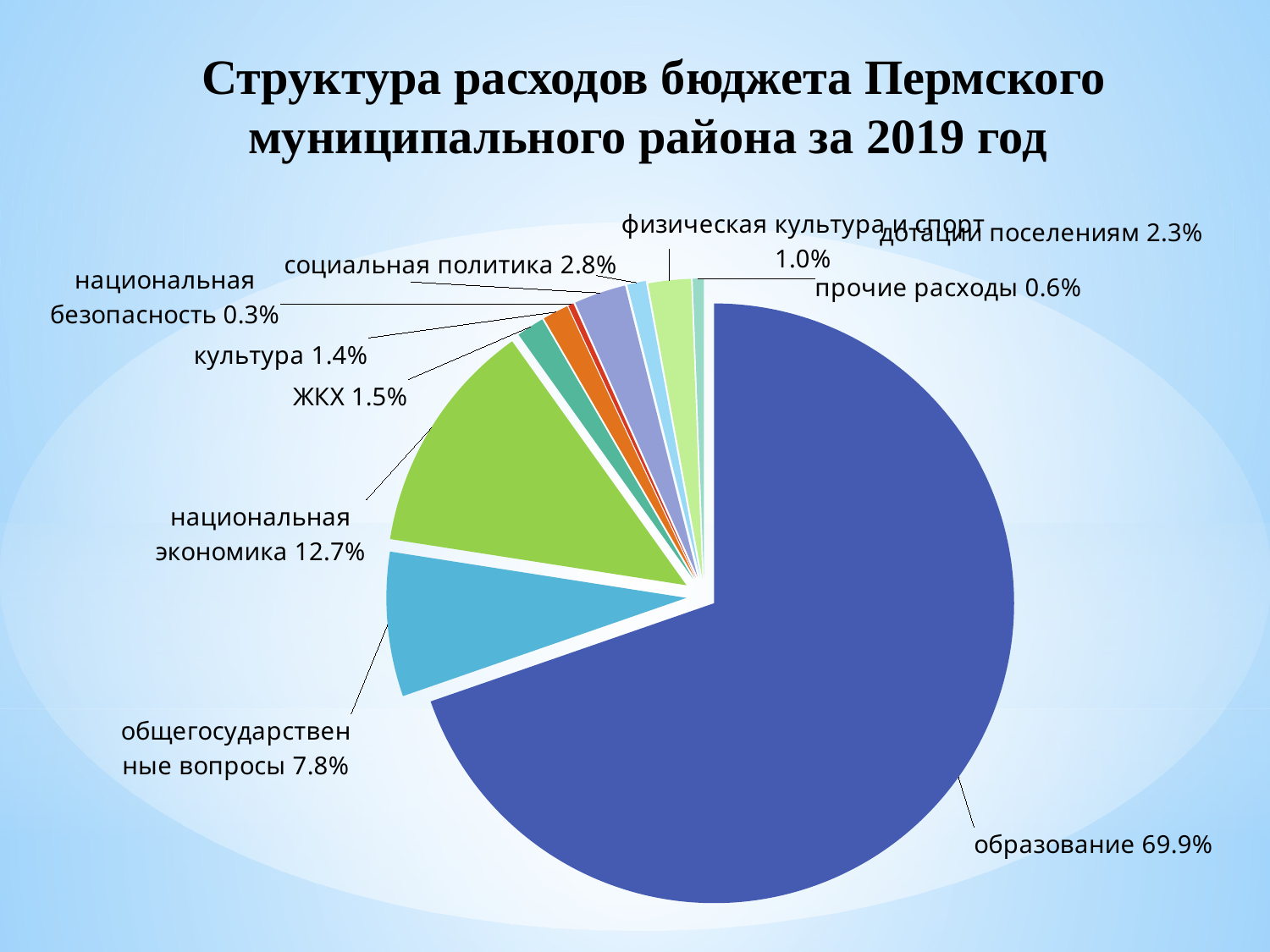
What is the value shown for общегосударственные вопросы? 7.8% Which category has the largest slice of the pie? образование What is the difference between the shares of национальная экономика and общегосударственные вопросы? 4.9% What is the value shown for национальная экономика? 12.7% How many categories are shown in the pie chart? 10 What is the title of the slide? Структура расходов бюджета Пермского муниципального района за 2019 год Which category has the smallest slice of the pie? национальная безопасность What is the value shown for социальная политика? 2.8% What is the value shown for дотации поселениям? 2.3% What share of the pie does образование account for? 69.9% What kind of chart is shown on the slide? pie chart Which is larger, the share for ЖКХ or the share for культура? ЖКХ